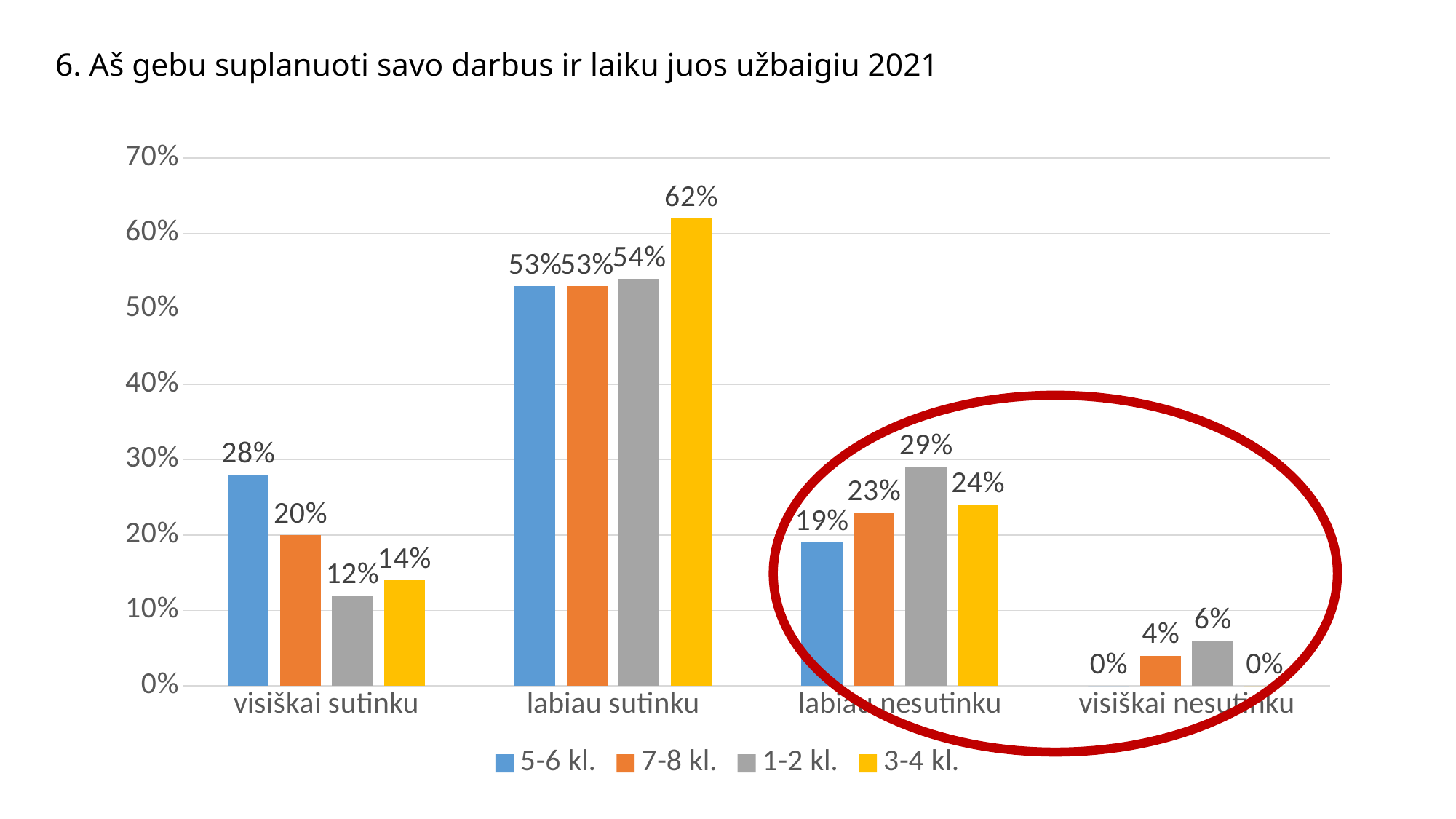
What kind of chart is shown on the slide? bar chart How many categories are shown on the x axis? 4 What is the value for 5-6 kl. in the 'visiškai sutinku' category? 28% What is the value for 1-2 kl. in the 'labiau nesutinku' category? 29% Which series has the highest value in the 'labiau sutinku' category? 3-4 kl. Which series has the lowest value in the 'visiškai sutinku' category? 1-2 kl. What is the difference between the 3-4 kl. and 5-6 kl. values in the 'labiau sutinku' category? 9% Which is larger: the 7-8 kl. value for 'visiškai sutinku' or the 7-8 kl. value for 'labiau nesutinku'? labiau nesutinku What is the value for 3-4 kl. in the 'labiau sutinku' category? 62% What is the value for 7-8 kl. in the 'visiškai nesutinku' category? 4% How many series does the legend list? 4 What is the title of the chart? 6. Aš gebu suplanuoti savo darbus ir laiku juos užbaigiu 2021